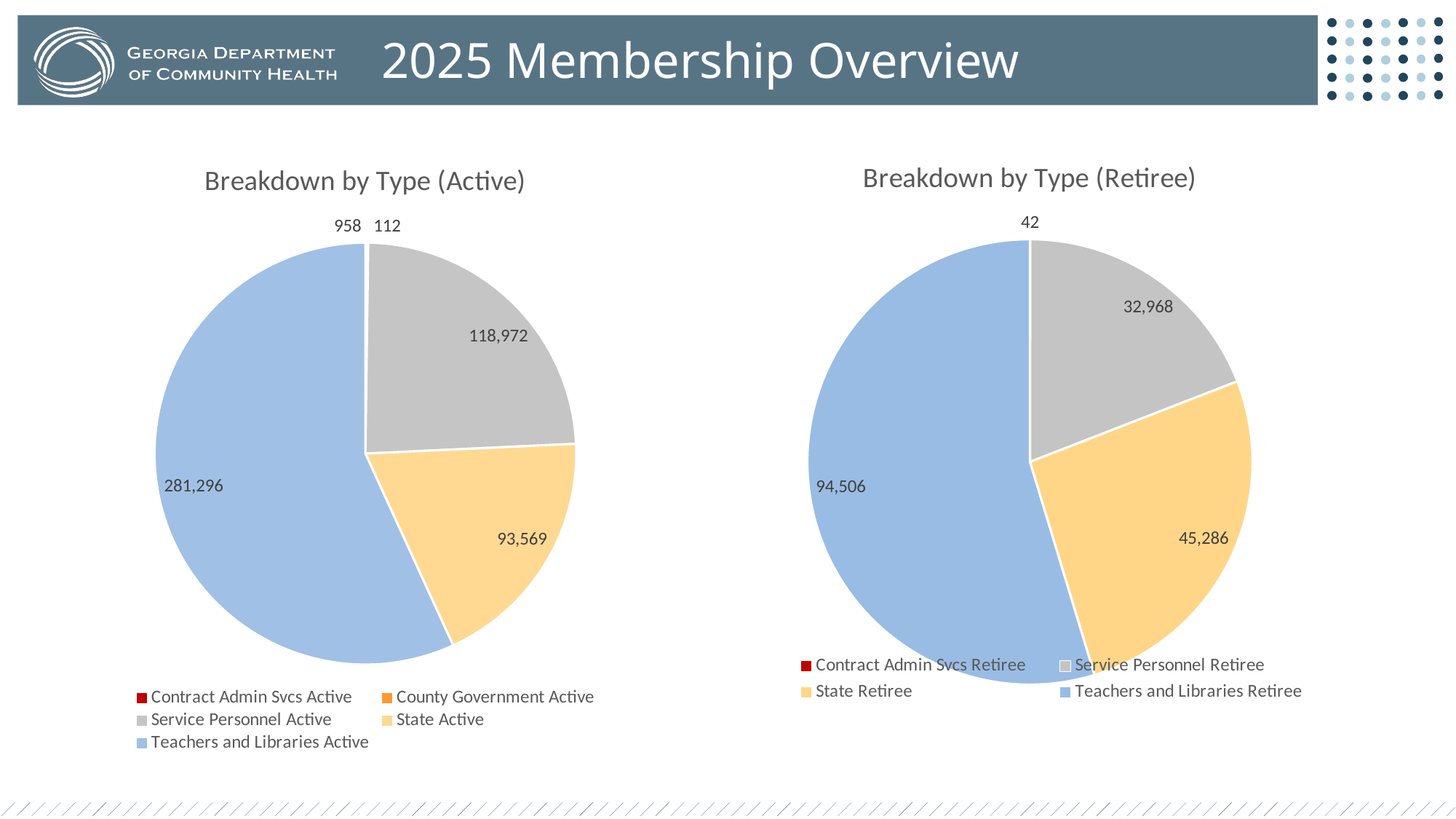
In the Breakdown by Type (Active) chart, what is the difference between Teachers and Libraries Active and Service Personnel Active? 162,324 In the Breakdown by Type (Active) chart, what is the value for Service Personnel Active? 118,972 In the Breakdown by Type (Retiree) chart, what is the value for Teachers and Libraries Retiree? 94,506 How many categories does the legend of the Breakdown by Type (Active) chart list? 5 In the Breakdown by Type (Active) chart, what is the value for State Active? 93,569 In the Breakdown by Type (Active) chart, what is the value for Teachers and Libraries Active? 281,296 In the Breakdown by Type (Retiree) chart, what is the difference between Teachers and Libraries Retiree and State Retiree? 49,220 In the Breakdown by Type (Retiree) chart, which is larger: State Retiree or Service Personnel Retiree? State Retiree What kind of chart is the Breakdown by Type (Retiree) chart? Pie chart In the Breakdown by Type (Retiree) chart, which category has the largest slice? Teachers and Libraries Retiree In the Breakdown by Type (Retiree) chart, which category has the smallest slice? Contract Admin Svcs Retiree In the Breakdown by Type (Retiree) chart, what is the value for Contract Admin Svcs Retiree? 42